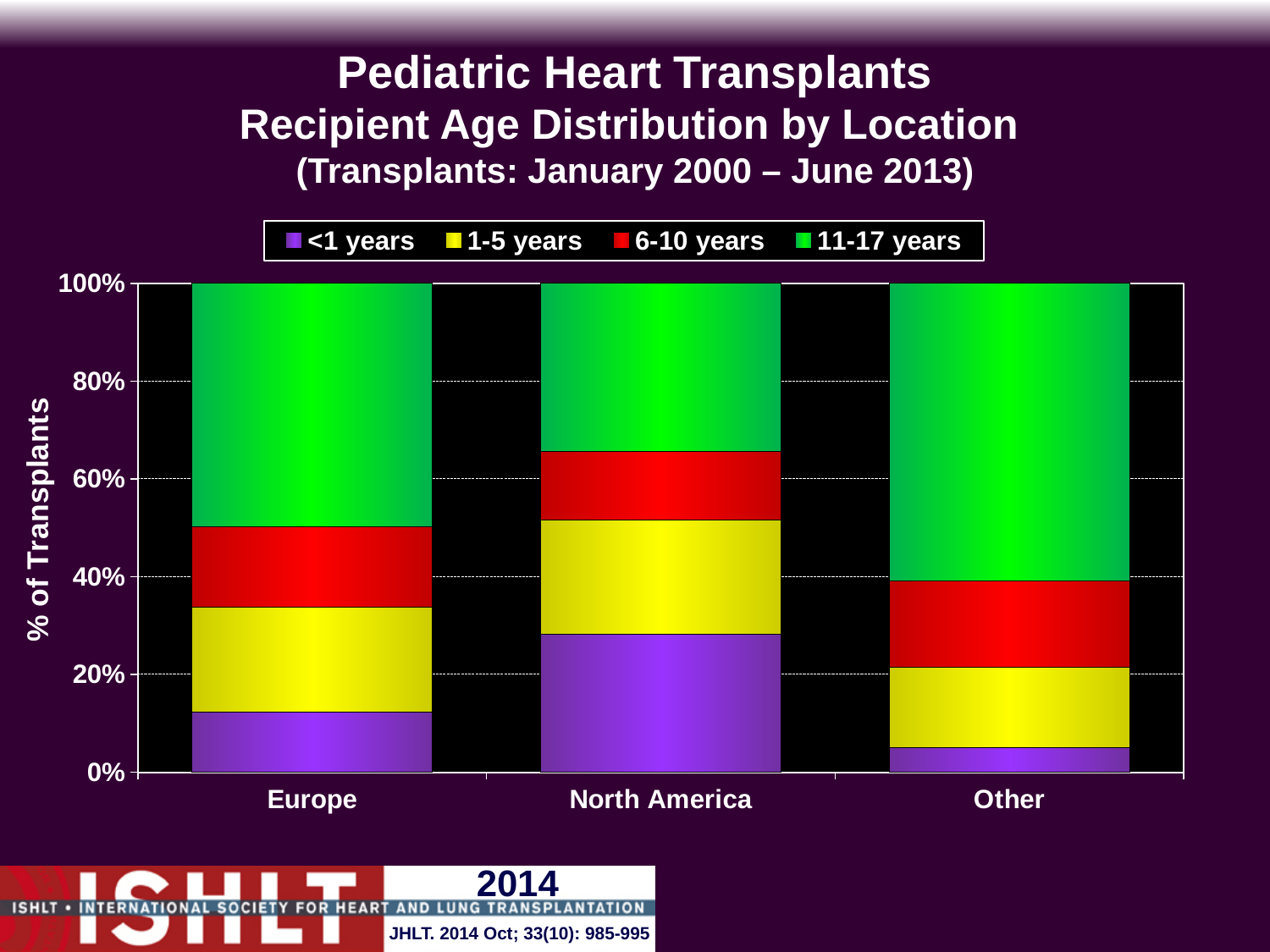
How many age groups does the legend list? 4 Is the share of <1 years recipients in Europe greater or less than 20%? less Which location has the largest share of recipients aged <1 years? North America Which colour represents the 6-10 years age group in the legend? red Which location has the smallest share of recipients aged <1 years? Other Which has a larger share of 1-5 years recipients, Europe or Other? Europe What kind of chart is shown on the slide? stacked bar chart Is the share of 11-17 years recipients in Europe greater or less than 40%? greater Is the share of 11-17 years recipients in North America greater or less than 40%? less Which location has the largest share of recipients aged 11-17 years? Other How many locations are shown on the x axis? 3